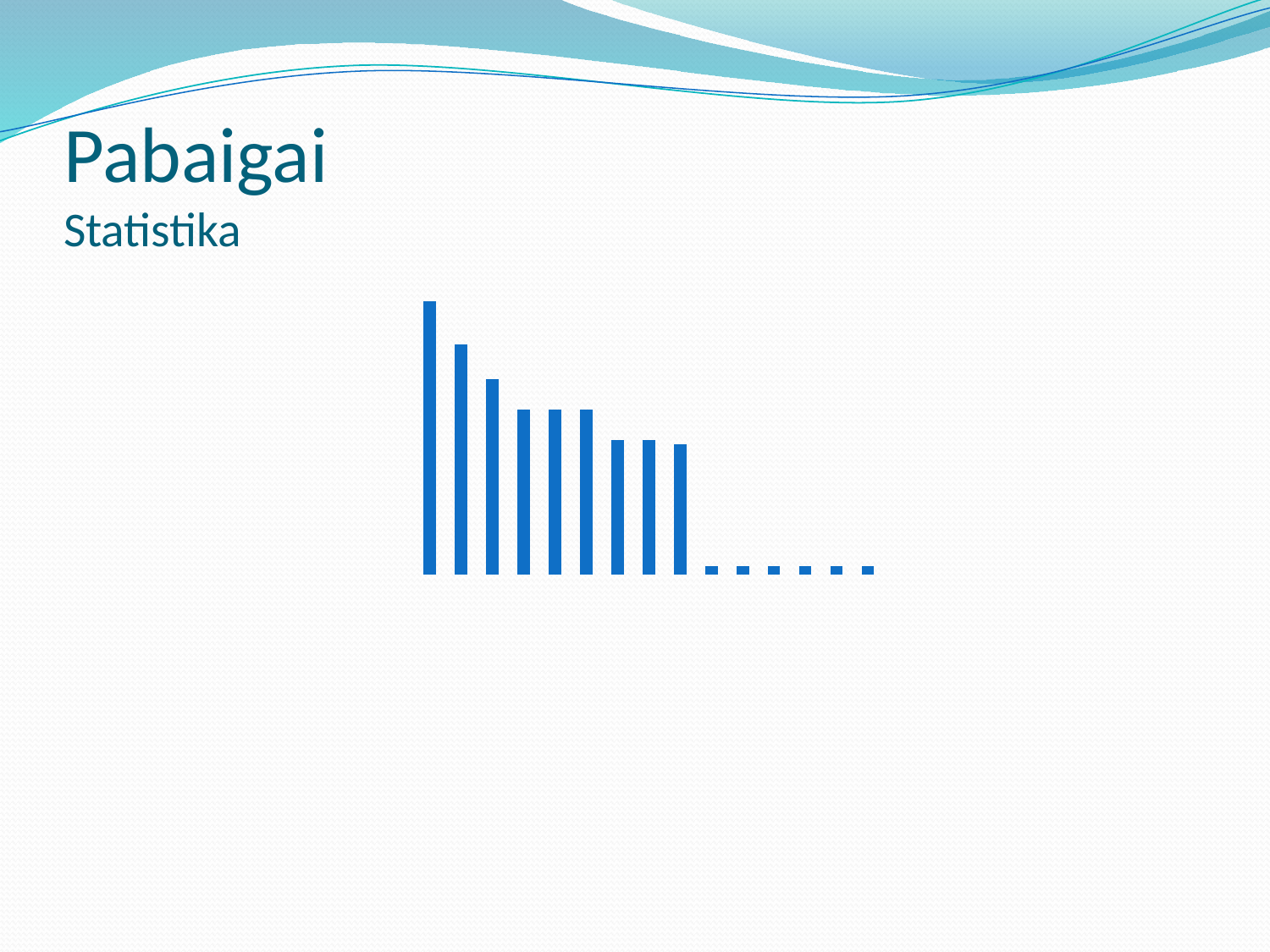
How many bars does the chart contain? 15 What colour are the bars in the chart? blue What kind of chart is shown on the slide? bar chart Do the bar values rise or fall from left to right across the chart? fall What is the heading text above the chart on the slide? Statistika Which bar is the tallest in the chart? the leftmost bar Which is taller, the third bar from the left or the fourth bar from the left? the third bar from the left Which is taller, the leftmost bar or the second bar from the left? the leftmost bar